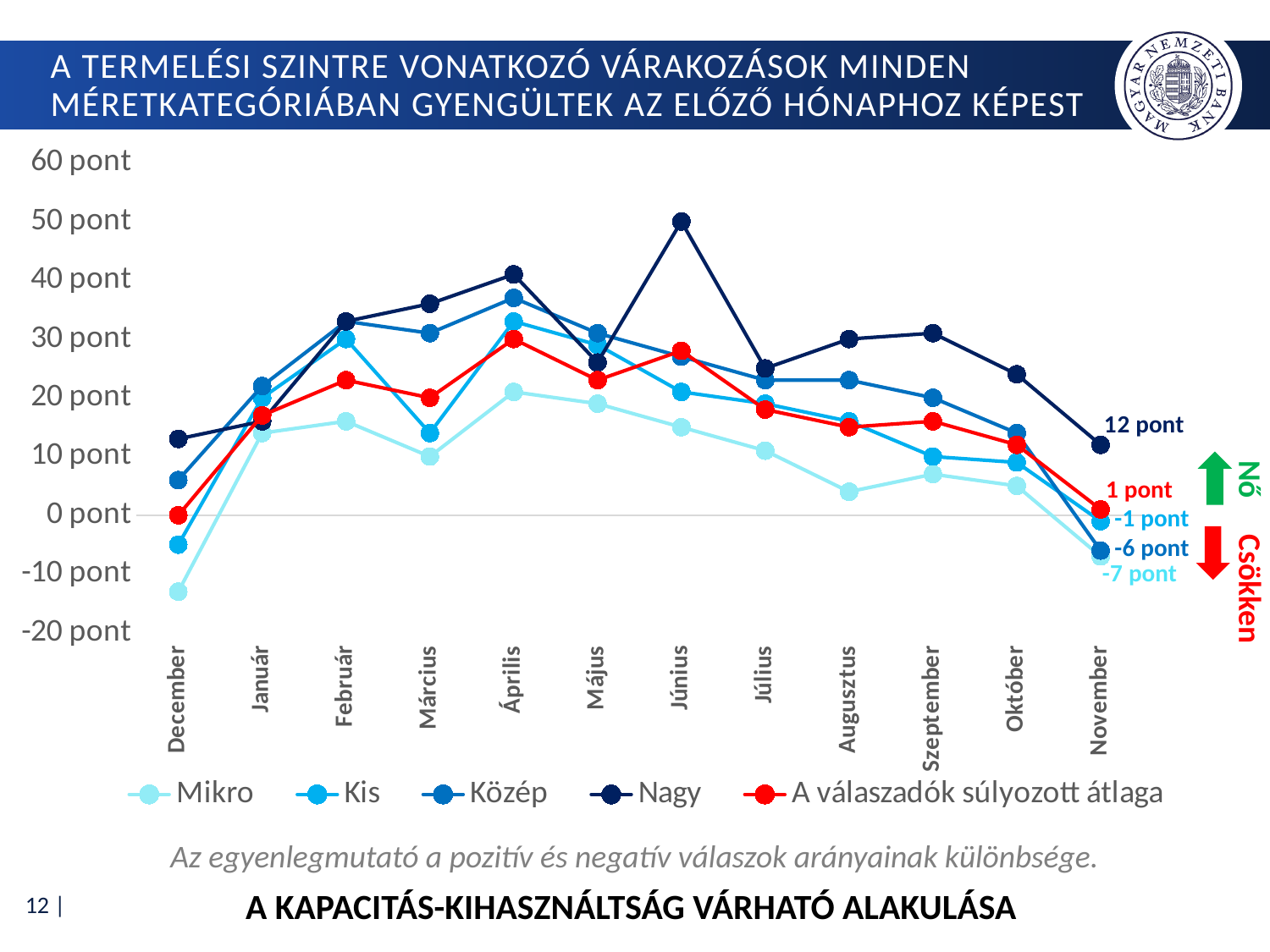
In November, which is larger: the value for Kis or the value for Közép? Kis Which series has the lowest value in November? Mikro What is the difference between the Nagy and Mikro values in November? 19 pont What is the value for Közép in November? -6 pont What is the value for Nagy in November? 12 pont What kind of chart is shown on the slide? line chart How many series does the legend list? 5 What is the value for A válaszadók súlyozott átlaga in November? 1 pont How many months are shown on the x axis? 12 Is the value for Nagy in Június greater or less than 40 pont? greater What is the value for Mikro in November? -7 pont Which series has the highest value in November? Nagy